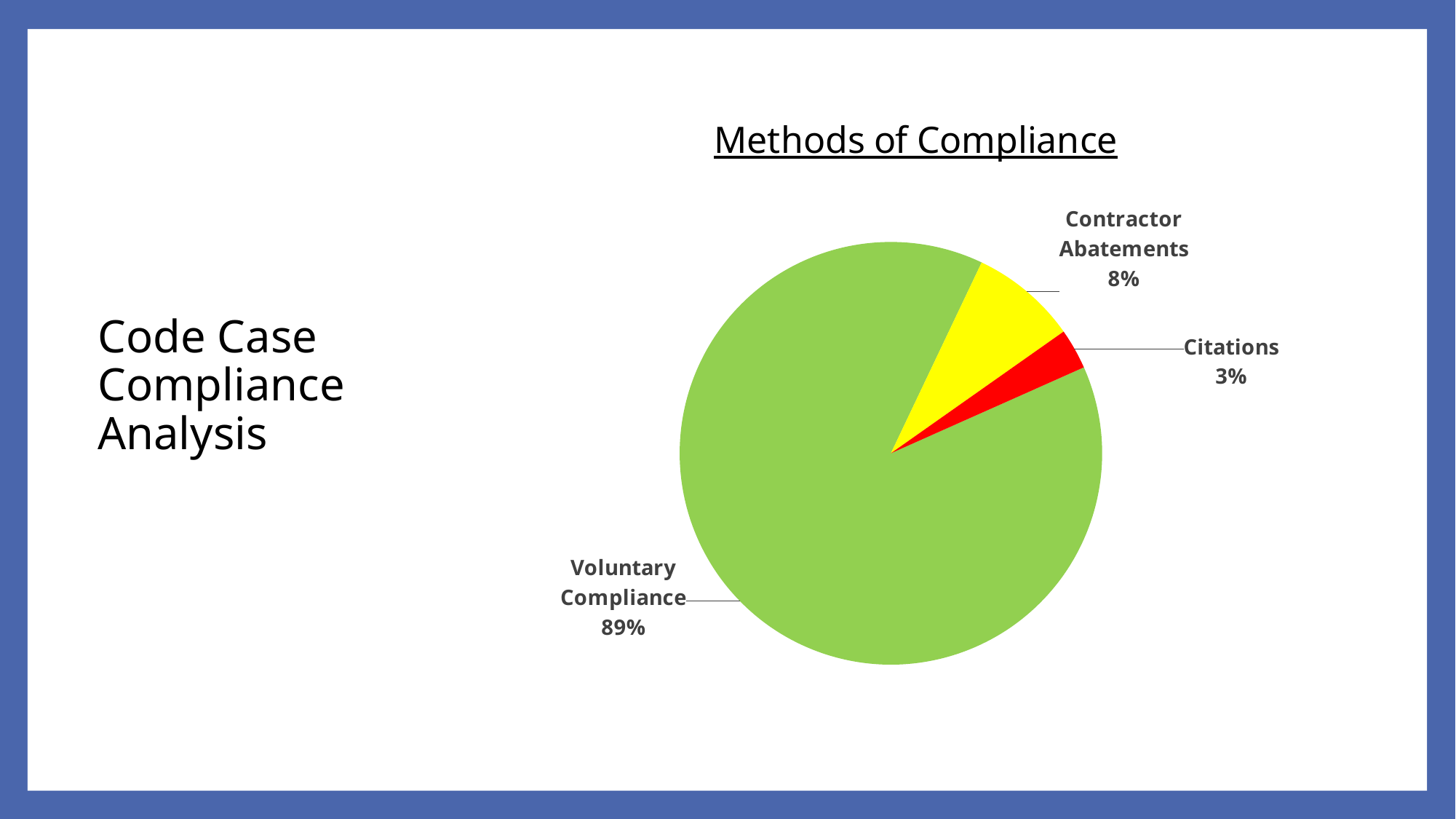
What is the title of the chart? Methods of Compliance How many categories are shown in the pie chart? 3 What share of the pie does Citations represent? 3% What is the difference in percentage points between Voluntary Compliance and Contractor Abatements? 81% Which is larger, Contractor Abatements or Citations? Contractor Abatements What colour is the Citations slice? Red Which category has the smallest slice of the pie? Citations What kind of chart is shown on the slide? Pie chart Which category has the largest slice of the pie? Voluntary Compliance What share of the pie does Contractor Abatements represent? 8% What is the difference in percentage points between Contractor Abatements and Citations? 5% What share of the pie does Voluntary Compliance represent? 89%